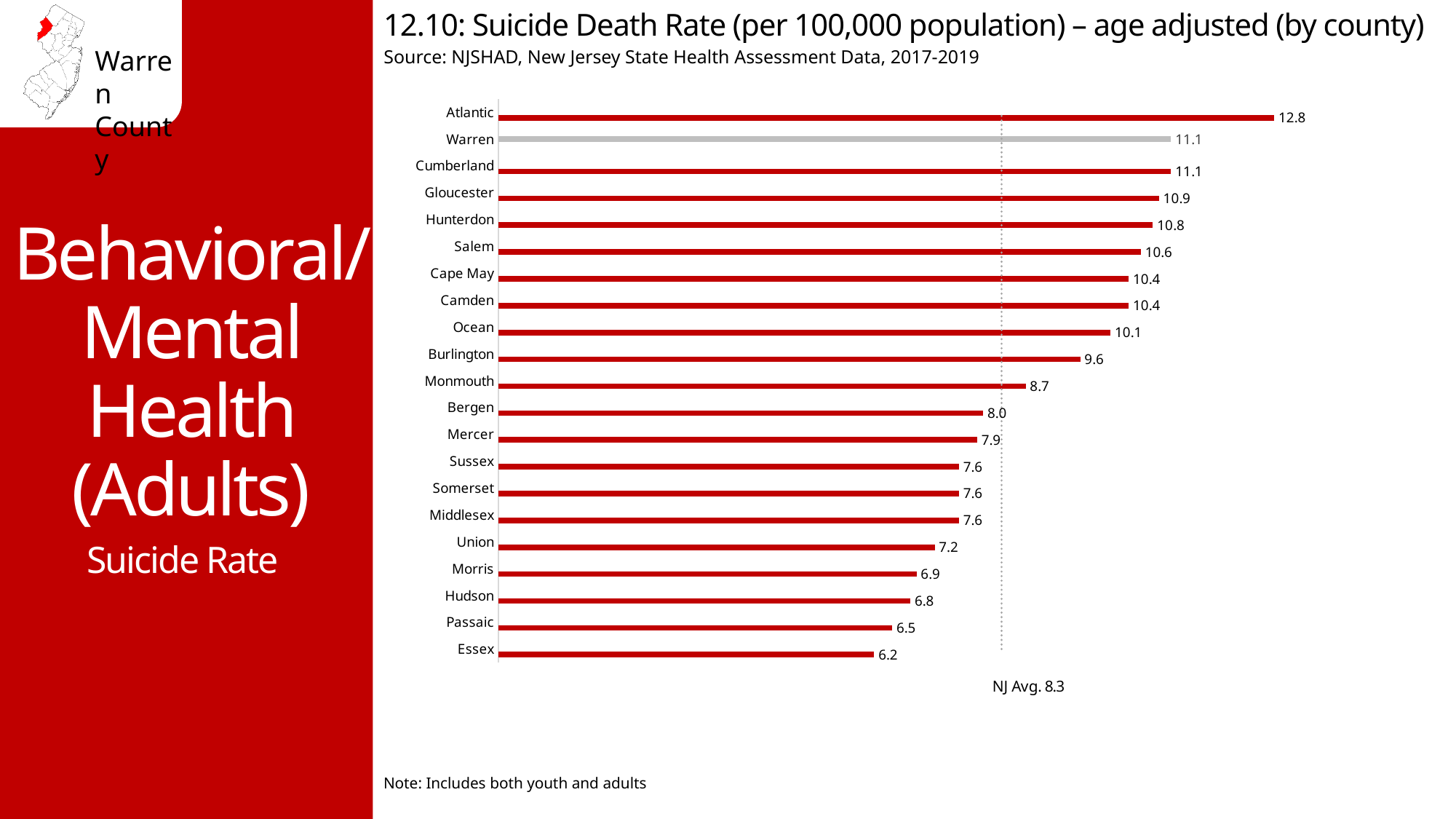
What is the suicide death rate for Warren County? 11.1 What is the difference between Warren County's suicide death rate and the NJ average? 2.8 What is the NJ average suicide death rate shown on the chart? 8.3 How many counties are shown in the chart? 21 What type of chart is shown on the slide? Bar chart What is the difference between the suicide death rates of Atlantic and Warren counties? 1.7 Which county has the highest suicide death rate? Atlantic What is the suicide death rate for Atlantic County? 12.8 Which county has the lowest suicide death rate? Essex Which county has a higher suicide death rate, Hunterdon or Monmouth? Hunterdon Which county's bar is shown in gray rather than red? Warren What is the suicide death rate for Essex County? 6.2